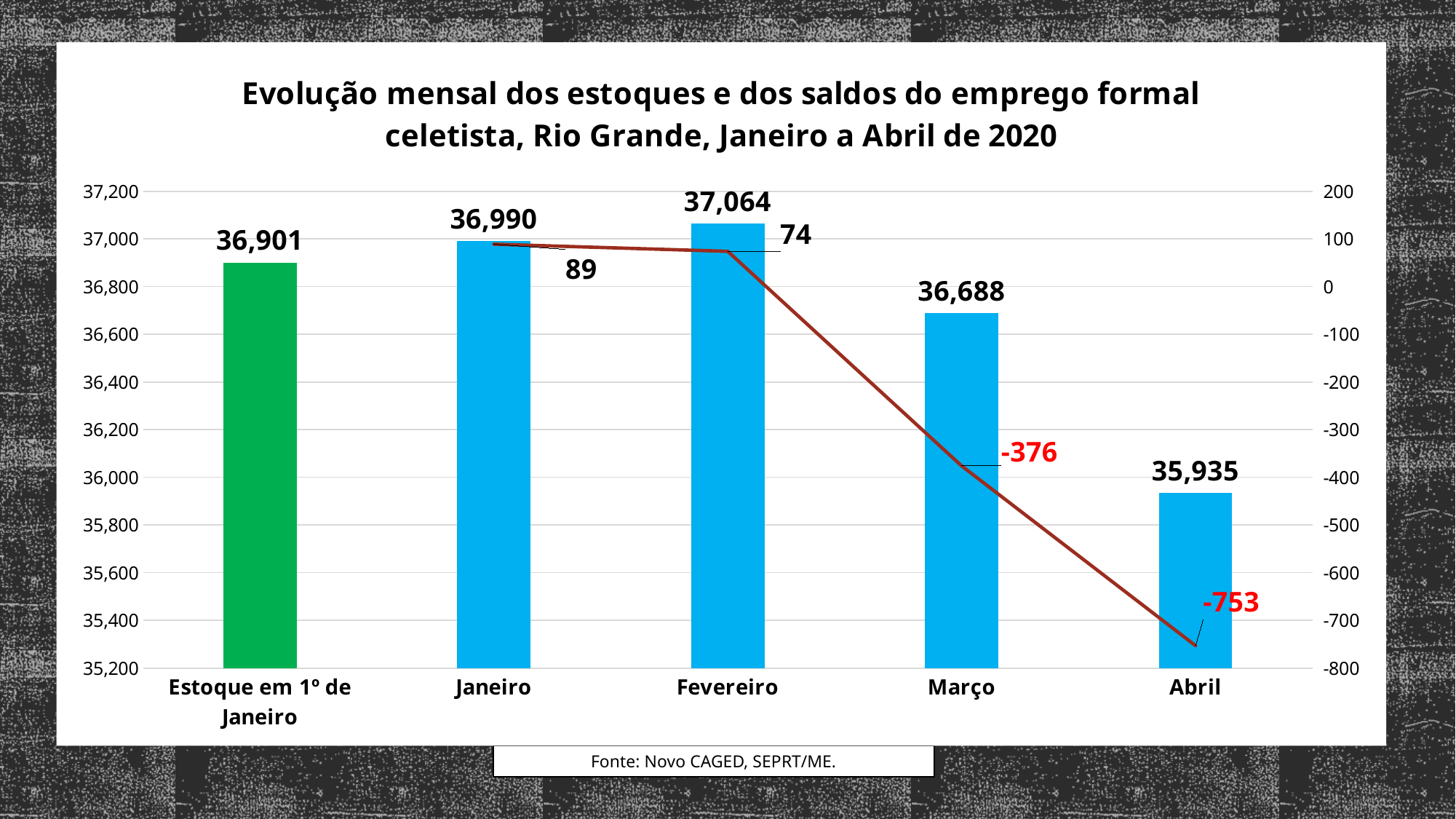
Which category has the lowest bar value? Abril What is the value of the line (saldo) for Março? -376 What is the difference between the line values for Janeiro and Fevereiro? 15 What is the difference between the bar values for Fevereiro and Março? 376 Which category has the highest bar value? Fevereiro What is the stock (bar) value for Abril? 35,935 What is the value of the line (saldo) for Janeiro? 89 What is the stock (bar) value for Fevereiro? 37,064 Does the line (saldo) rise or fall from Fevereiro to Abril? fall How many bars are plotted in the chart? 5 What colour is the bar for 'Estoque em 1º de Janeiro'? green Which is larger, the bar value for Janeiro or for 'Estoque em 1º de Janeiro'? Janeiro